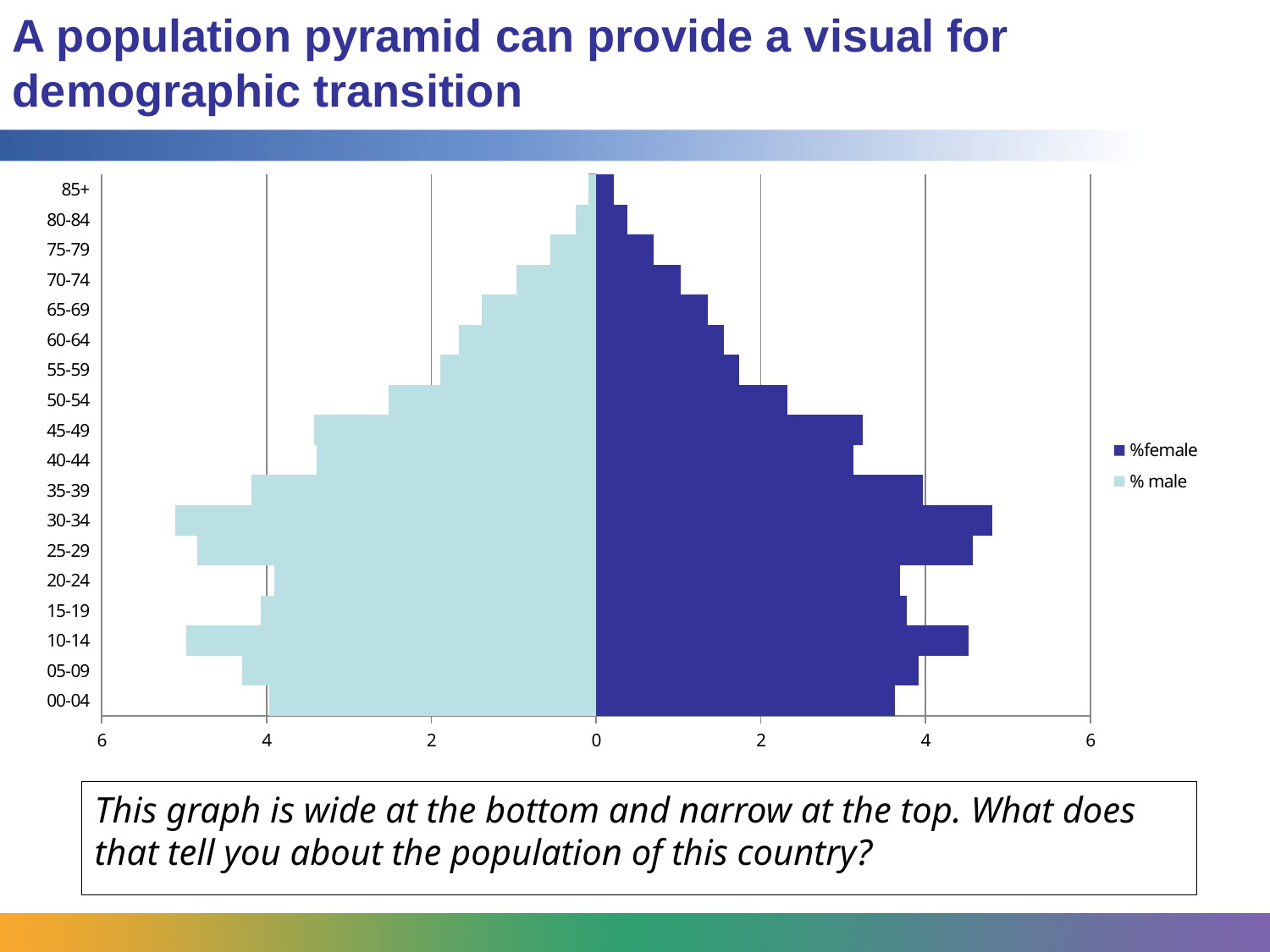
Which age group has the lowest %female value? 85+ How many age groups are shown on the vertical axis of the chart? 18 Which age group has the lowest % male value? 85+ Which is larger, the % male value for 30-34 or the % male value for 60-64? 30-34 Is the % male value for the 45-49 age group greater or less than 4? less Is the % male value for the 30-34 age group greater or less than 4? greater How many series does the chart legend list? 2 Moving from the 00-04 age group up to the 85+ age group, do the bars generally get shorter or longer? shorter Is the %female value for the 70-74 age group greater or less than 2? less Which colour represents the %female series in the chart? dark blue What kind of chart is shown on the slide? bar chart